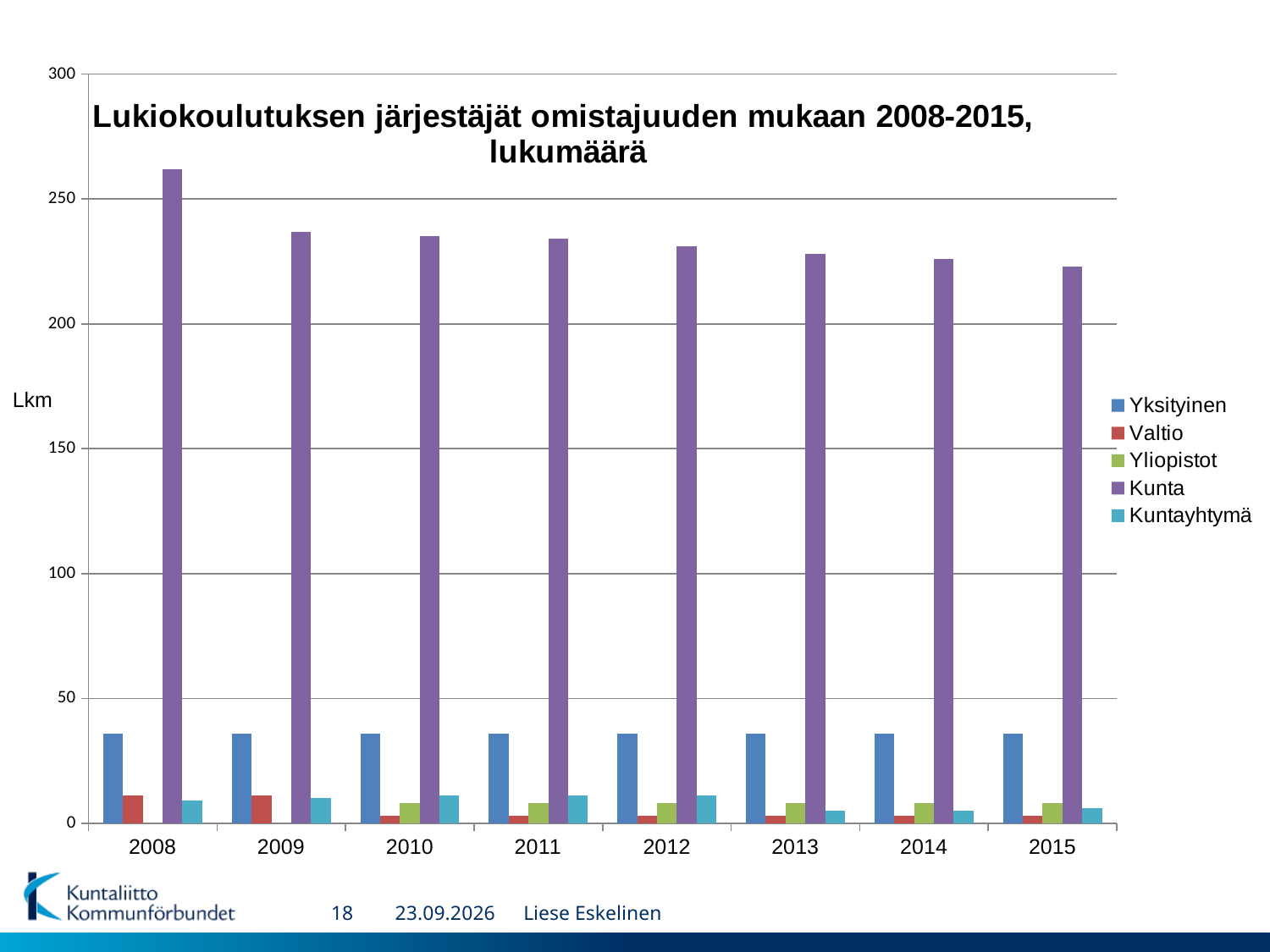
Which is larger for Valtio, the value in 2008 or the value in 2015? 2008 What is the label on the vertical axis? Lkm Do the Kunta values rise or fall from 2008 to 2015? fall How many series does the legend list? 5 Is the value for Kunta in 2008 greater or less than 250? greater How many years are shown on the x axis? 8 Which series has the highest value in 2008? Kunta Is the value for Kunta in 2015 greater or less than 250? less What kind of chart is shown on the slide? bar chart In which year is the Kunta value highest? 2008 Is the value for Yksityinen in 2010 greater or less than 50? less Which is larger in 2012, Kunta or Yksityinen? Kunta